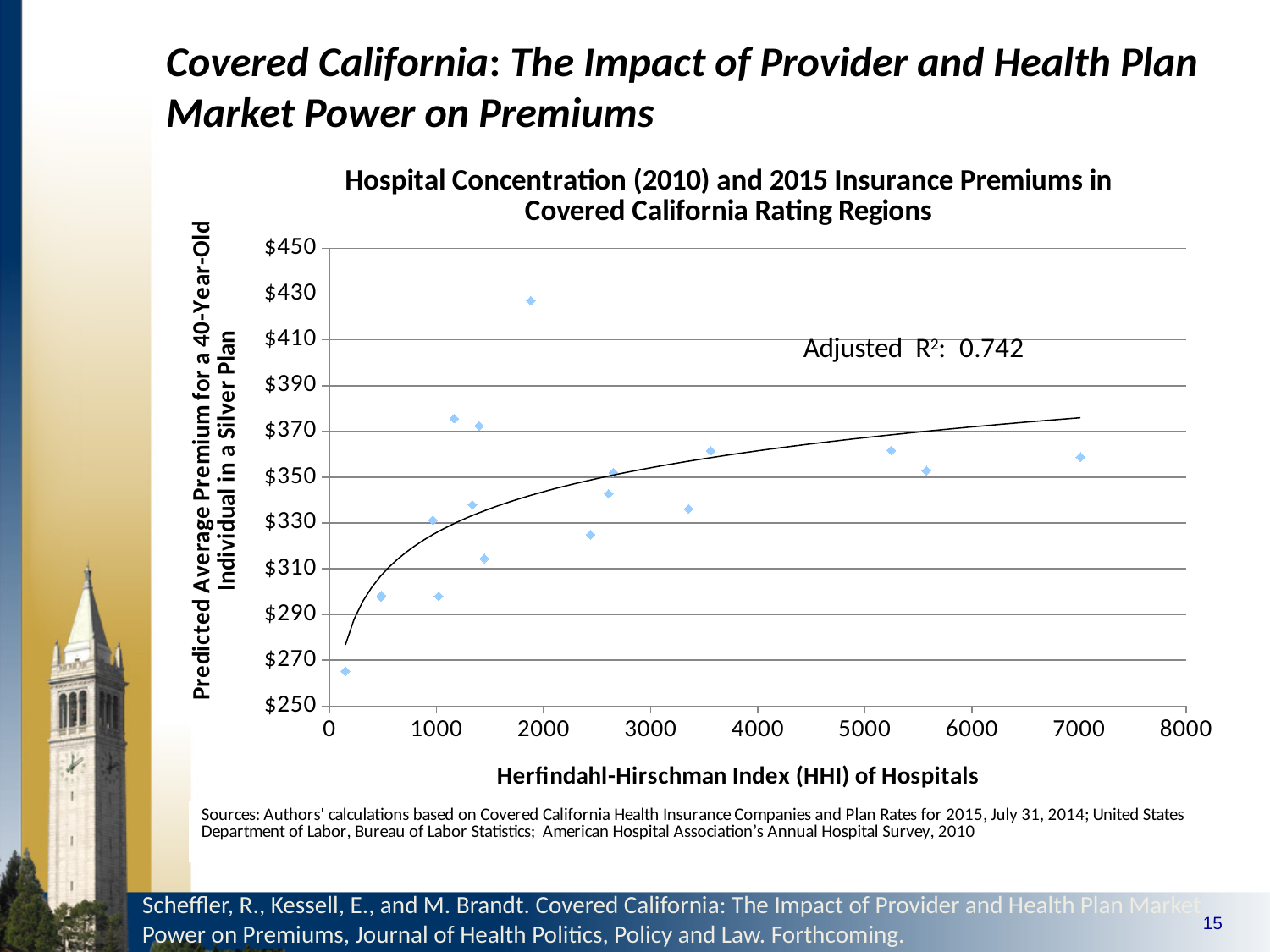
According to the fitted line, do predicted premiums rise or fall as the Herfindahl-Hirschman Index increases? rise Is the premium for the point with the highest HHI (around 7000) greater or less than $370? less What kind of chart is shown on the slide? scatter chart What adjusted R² value is printed on the chart? 0.742 What is the title of the chart? Hospital Concentration (2010) and 2015 Insurance Premiums in Covered California Rating Regions What is the maximum value shown on the x axis? 8000 Is the highest plotted premium value greater or less than $410? greater